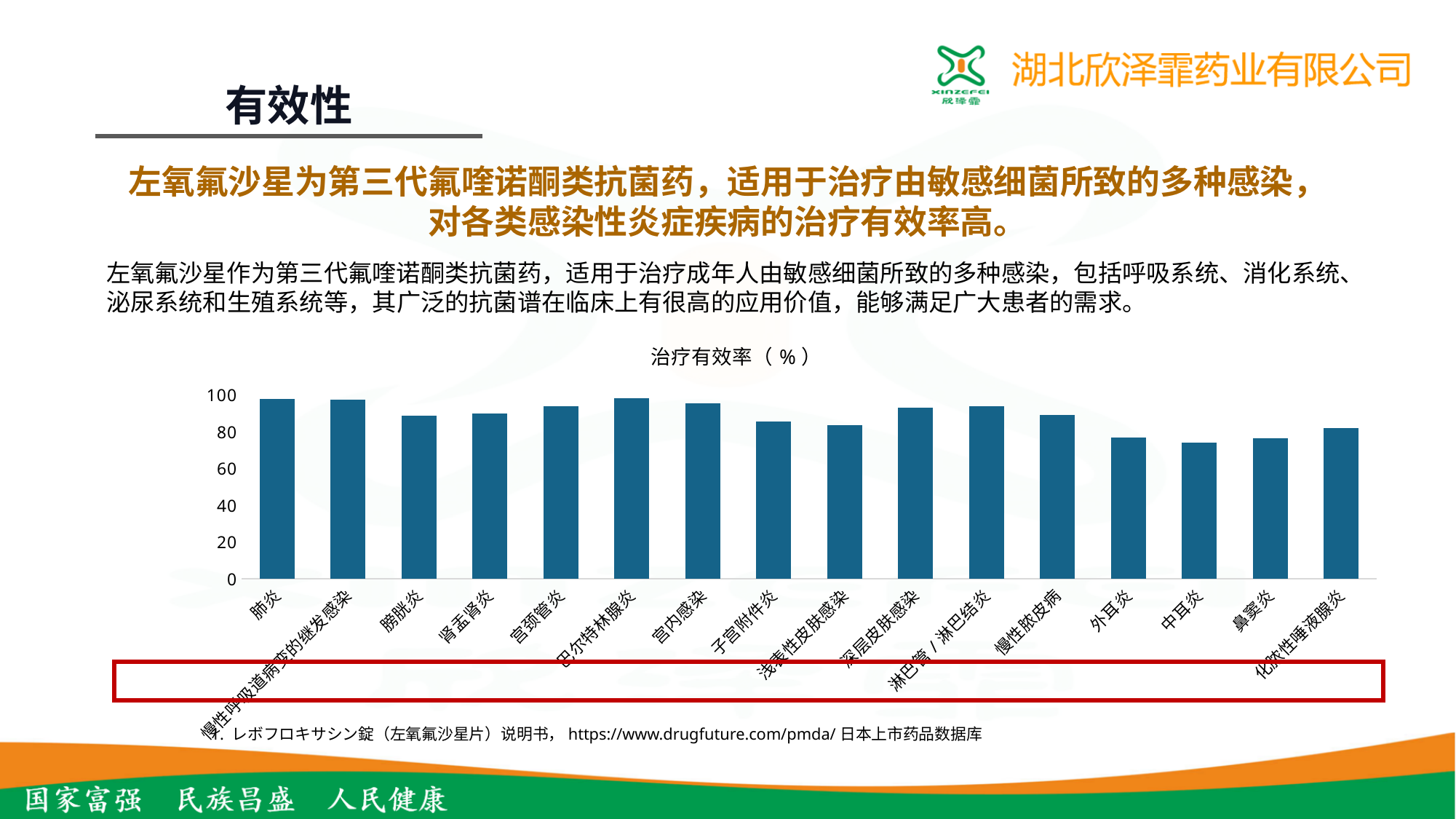
Is the value for 鼻窦炎 greater or less than 80? less Which has a higher value, 宫内感染 or 外耳炎? 宫内感染 What is the title of the chart? 治疗有效率（%） What kind of chart is shown on the slide? Bar chart Is the value for 宫内感染 greater or less than 80? greater Which has a higher value, 肺炎 or 中耳炎? 肺炎 How many categories (infection types) are plotted in the chart? 16 Is the value for 外耳炎 greater or less than 80? less Which has a higher value, 深层皮肤感染 or 浅表性皮肤感染? 深层皮肤感染